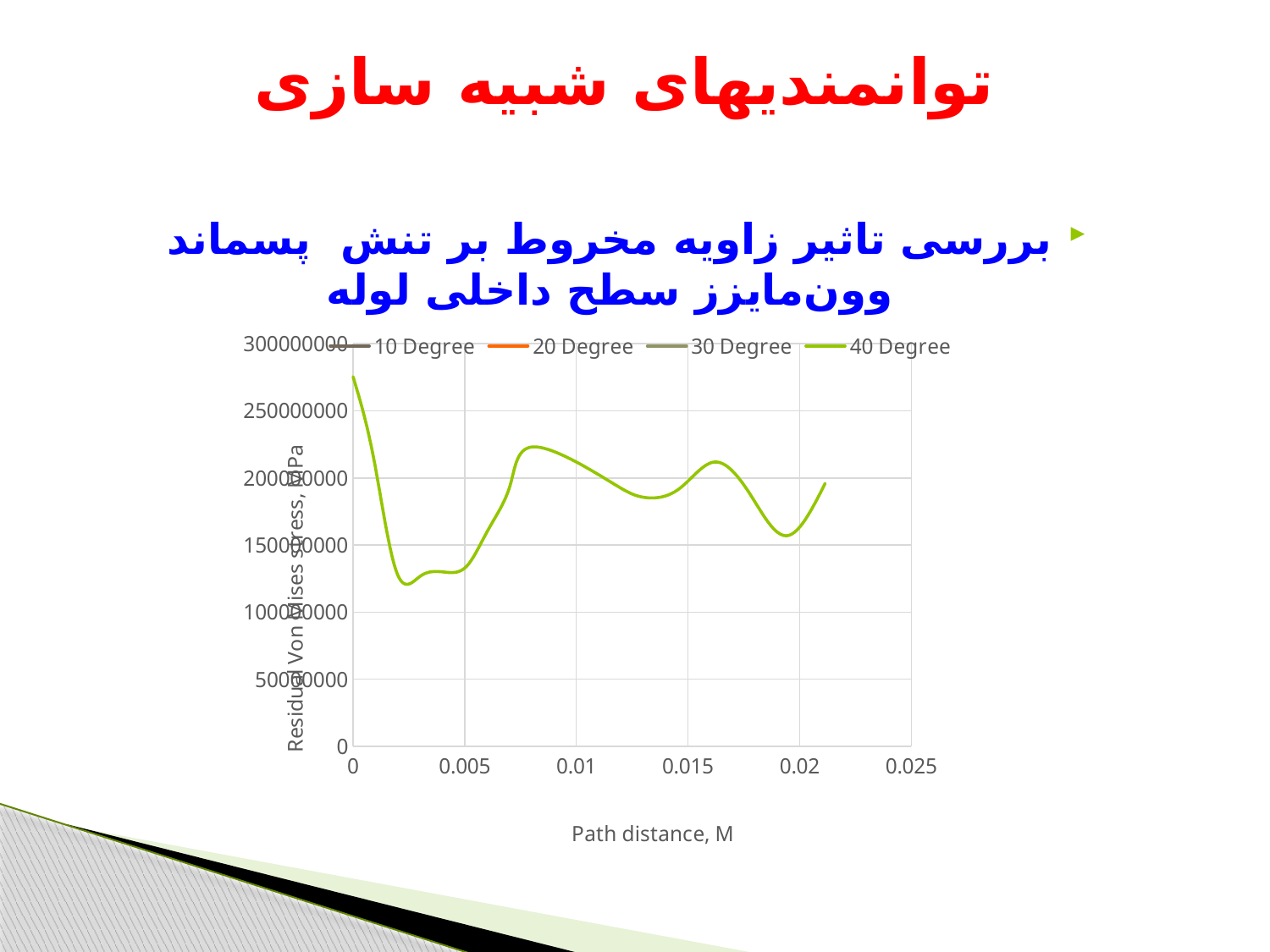
Is the value of the 40 Degree line at path distance 0.015 greater or less than 250000000? less Is the value of the 40 Degree line at path distance 0.01 greater or less than 150000000? greater How many series does the legend list? 4 Is the value of the 40 Degree line at path distance 0.005 greater or less than 150000000? less Does the 40 Degree line rise or fall between path distance 0.005 and 0.0075? rise Does the 40 Degree line rise or fall between path distance 0 and 0.005? fall Which series is drawn in green on the chart? 40 Degree What is the title of the vertical axis? Residual Von Mises stress, MPa At which path distance does the 40 Degree line reach its highest value? 0 What kind of chart is shown on the slide? line chart